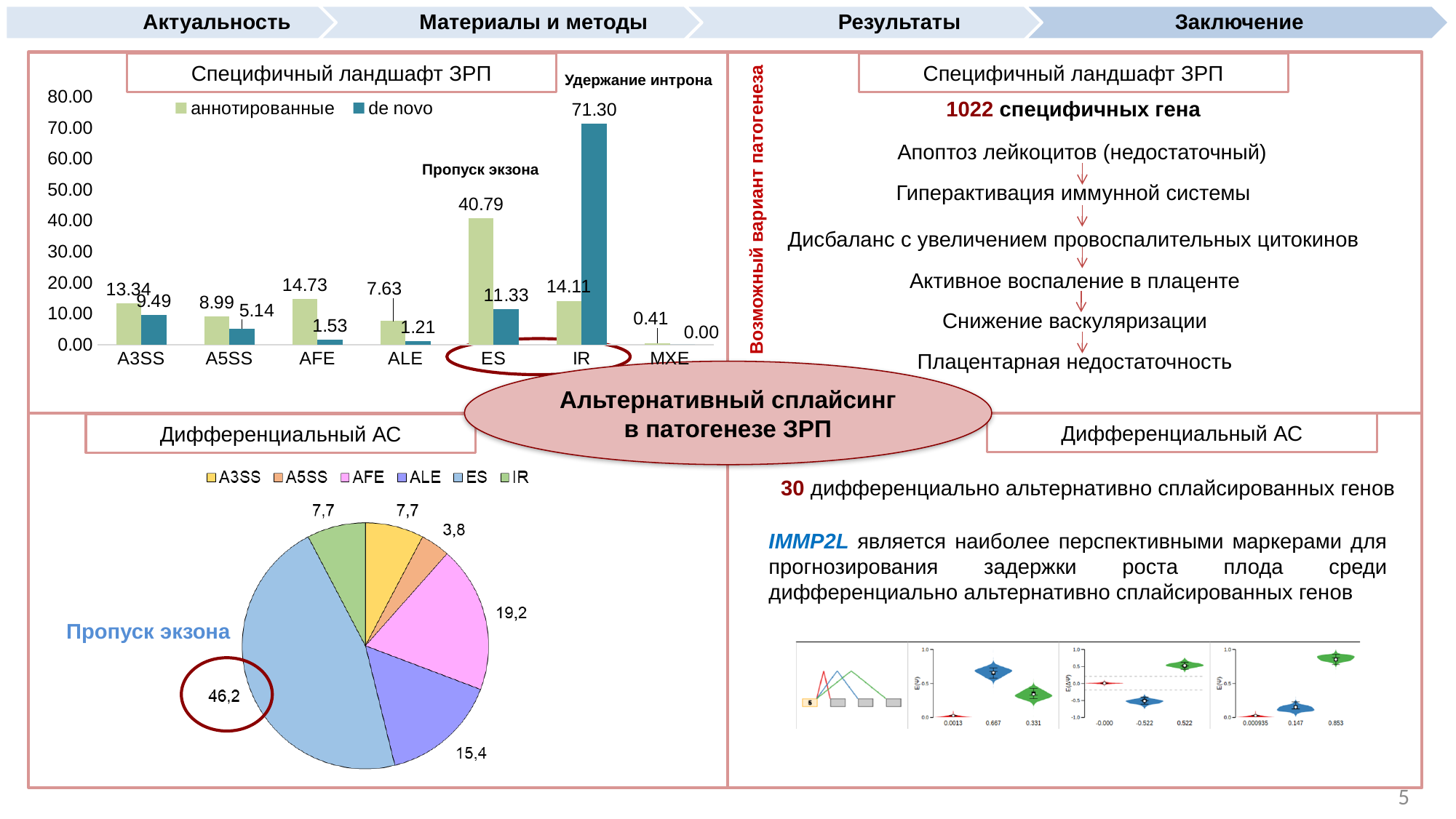
In the bar chart 'Специфичный ландшафт ЗРП', what is the value of the 'аннотированные' series for ES? 40.79 How many categories are shown on the x axis of the bar chart 'Специфичный ландшафт ЗРП'? 7 In the bar chart 'Специфичный ландшафт ЗРП', what is the 'de novo' value for AFE? 1.53 How many series does the legend of the bar chart 'Специфичный ландшафт ЗРП' list? 2 In the bar chart 'Специфичный ландшафт ЗРП', which category has the highest 'аннотированные' value? ES In the bar chart 'Специфичный ландшафт ЗРП', what is the difference between the 'аннотированные' and 'de novo' values for A3SS? 3.85 In the bar chart 'Специфичный ландшафт ЗРП', which category has the lowest 'de novo' value? MXE In the pie chart 'Дифференциальный АС', what is the value of the ES slice? 46,2 In the bar chart 'Специфичный ландшафт ЗРП', which is larger for IR: the 'аннотированные' value or the 'de novo' value? de novo What type of chart is used under the title 'Дифференциальный АС'? Pie chart In the bar chart 'Специфичный ландшафт ЗРП', what is the value of the 'de novo' series for IR? 71.30 In the pie chart 'Дифференциальный АС', which slice is the smallest? A5SS